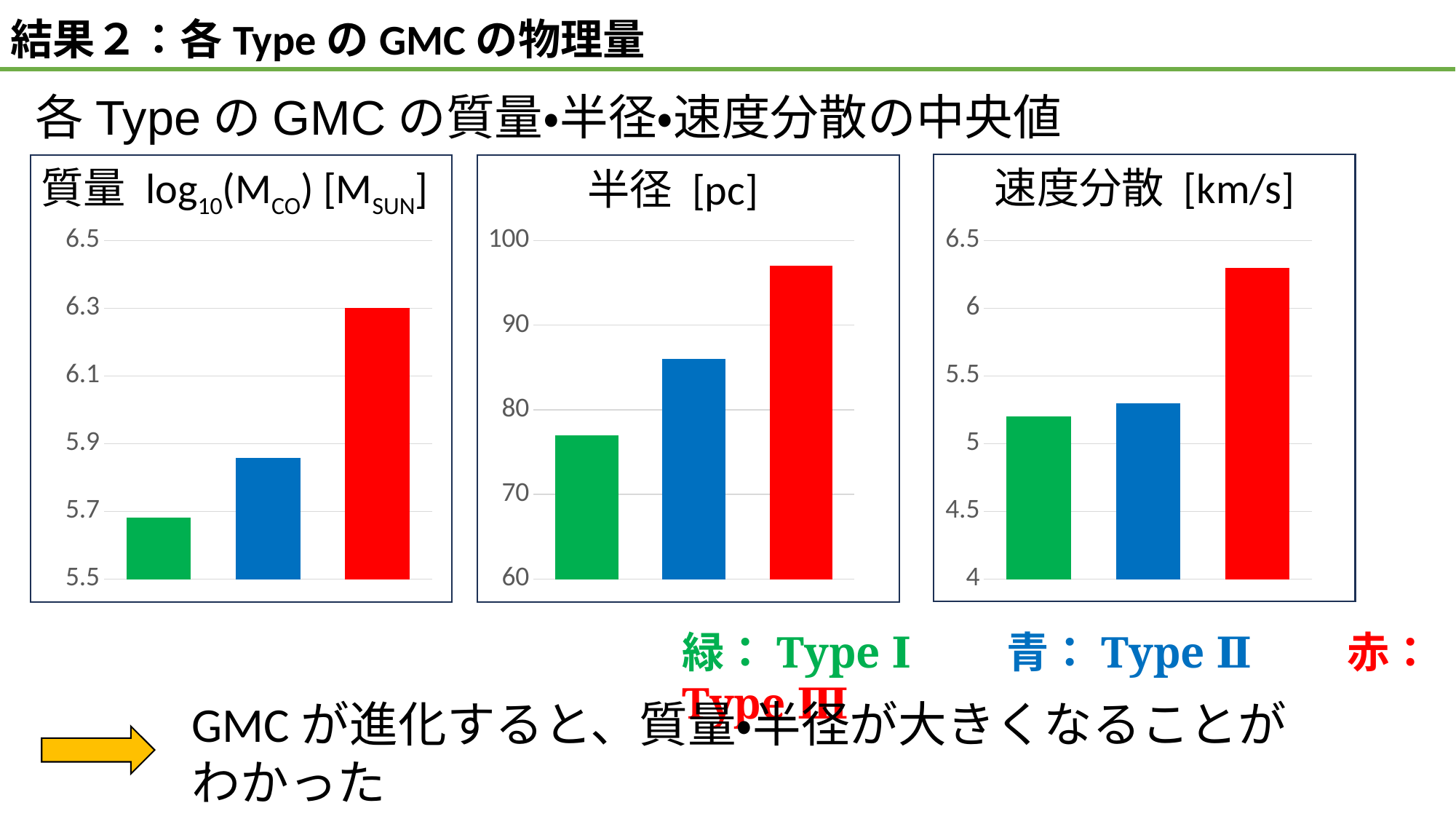
In the 半径 [pc] chart, is the value for Type I greater or less than 80? less In the 半径 [pc] chart, do the values rise or fall from Type I to Type III? rise In the 半径 [pc] chart, is the value for Type II greater or less than 80? greater What kind of chart is the 質量 (mass) chart on the left? bar chart In the 半径 [pc] chart, is the value for Type III greater or less than 90? greater In the 半径 [pc] chart, which Type has the lowest value? Type I In the 速度分散 [km/s] chart, which is larger, the value for Type I or Type II? Type II In the 質量 chart, which Type has the highest value? Type III How many bars are plotted in the 半径 [pc] chart? 3 According to the legend, which colour represents Type II? blue (青)